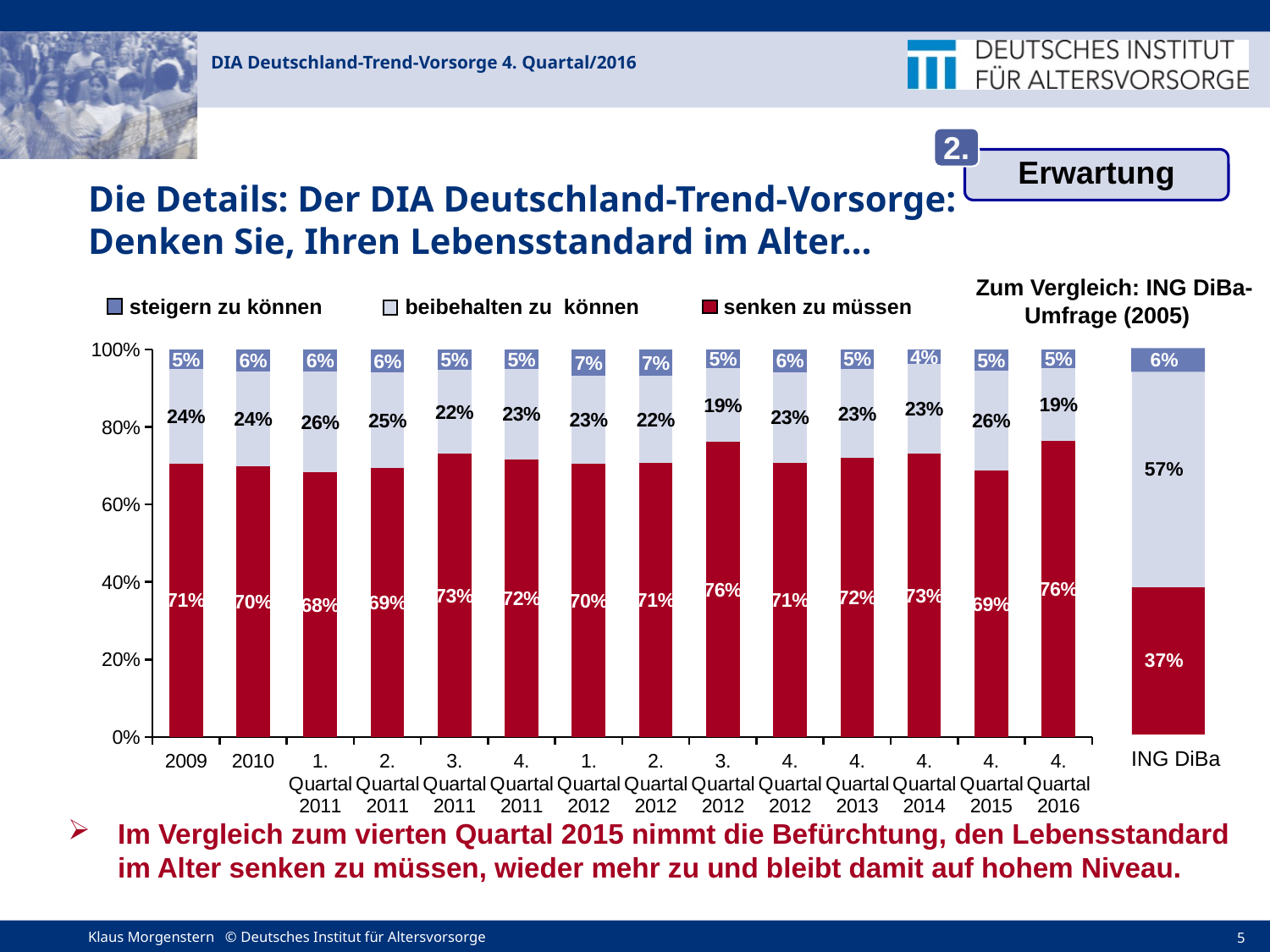
How many series does the legend of the main chart list? 3 In the main chart, which category has the lowest value for 'senken zu müssen'? 1. Quartal 2011 In the main chart, what percentage answered 'beibehalten zu können' in 2009? 24% What kind of chart is the main chart? Stacked bar chart In the main chart, what percentage answered 'senken zu müssen' in 4. Quartal 2016? 76% In the main chart, what is the difference between the 'senken zu müssen' values for 4. Quartal 2016 and 4. Quartal 2015? 7% In the comparison chart 'Zum Vergleich: ING DiBa-Umfrage (2005)', what percentage answered 'beibehalten zu können'? 57% In the main chart, which category has the lowest value for 'steigern zu können'? 4. Quartal 2014 How many categories are shown on the x axis of the main chart? 14 In the main chart, what percentage answered 'steigern zu können' in 1. Quartal 2012? 7% In the main chart, is the 'senken zu müssen' value larger in 3. Quartal 2011 or in 2. Quartal 2011? 3. Quartal 2011 In the comparison chart 'Zum Vergleich: ING DiBa-Umfrage (2005)', what percentage answered 'senken zu müssen'? 37%